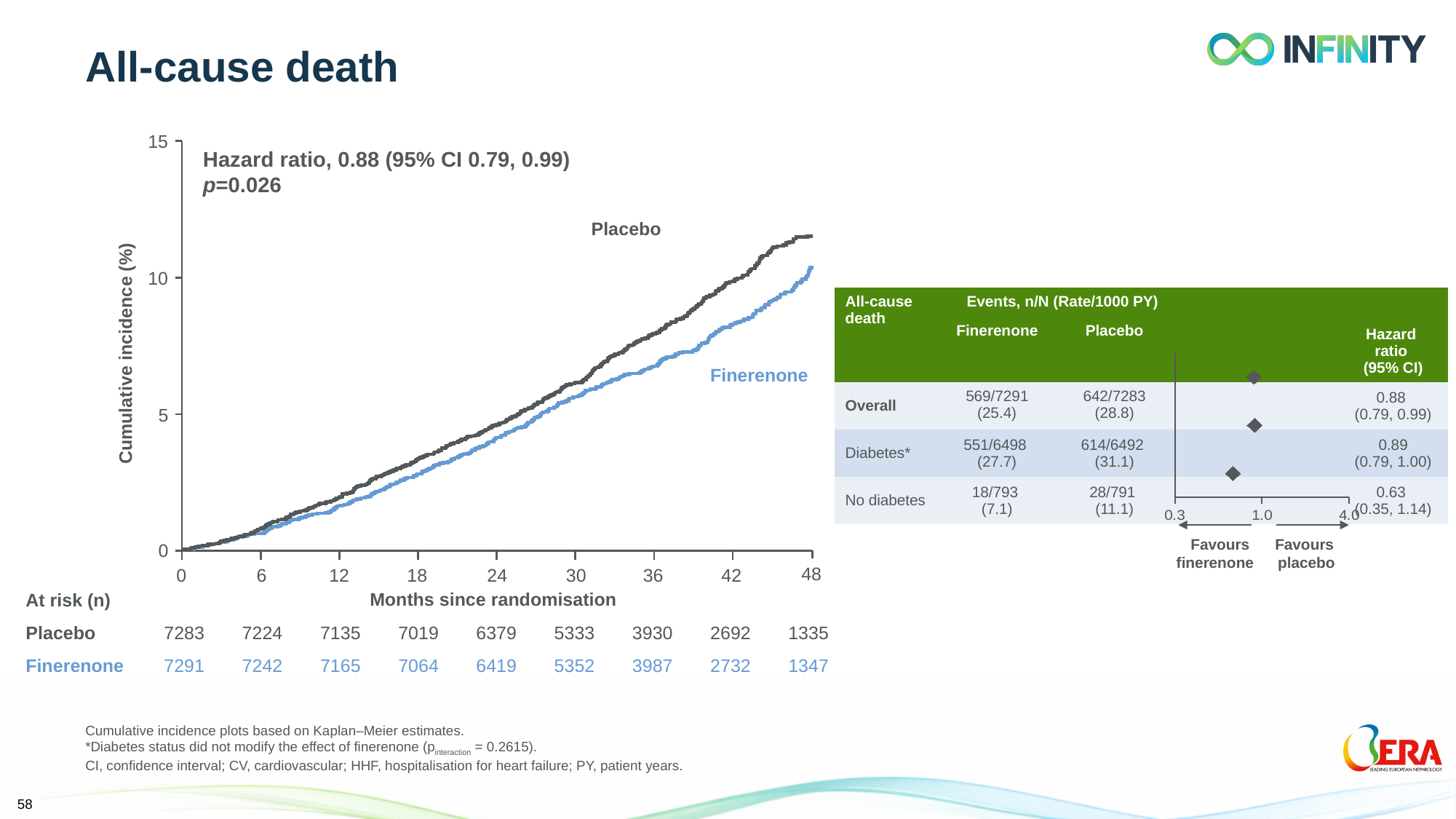
In the cumulative incidence chart, is the Finerenone value at 36 months greater or less than 5? greater What hazard ratio is printed on the cumulative incidence chart? 0.88 (95% CI 0.79, 0.99) What p-value is printed on the cumulative incidence chart? p=0.026 In the at-risk table below the cumulative incidence chart, what is the difference between the Finerenone and Placebo numbers at risk at 0 months? 8 In the cumulative incidence chart, which curve is higher at 48 months, Placebo or Finerenone? Placebo How many treatment groups are plotted as curves in the cumulative incidence chart? 2 In the at-risk table below the cumulative incidence chart, how many Placebo patients were at risk at 24 months? 6379 In the forest plot on the right, which subgroup has the lowest hazard ratio? No diabetes What kind of chart is the cumulative incidence plot on the left of the slide? line chart In the cumulative incidence chart, is the Placebo value at 48 months greater or less than 10? greater In the cumulative incidence chart, do the curves rise or fall as months since randomisation increase? rise What is the x-axis label of the cumulative incidence chart? Months since randomisation